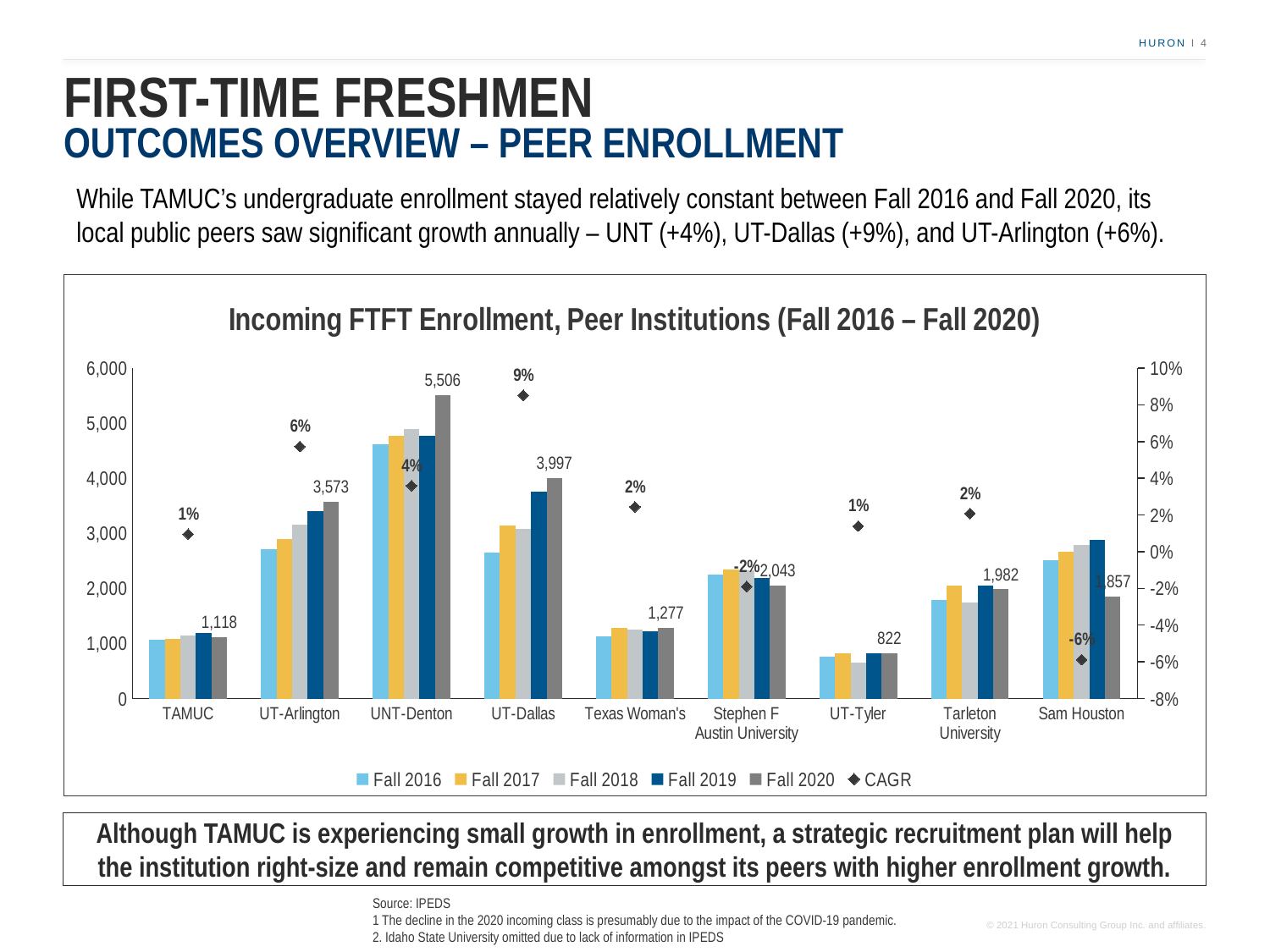
Which institution has the lowest Fall 2020 enrollment? UT-Tyler What is the Fall 2020 incoming FTFT enrollment for TAMUC? 1,118 What CAGR is shown for Sam Houston? -6% How many institutions are shown on the x axis? 9 Is the Fall 2016 enrollment for TAMUC greater or less than 2,000? less What is the Fall 2020 incoming FTFT enrollment for UNT-Denton? 5,506 How many series does the legend list? 6 Which has the larger Fall 2020 enrollment, Tarleton University or Sam Houston? Tarleton University Which institution has the highest Fall 2020 enrollment? UNT-Denton Which institution has the highest CAGR? UT-Dallas What CAGR is shown for UT-Dallas? 9% What is the difference between the Fall 2020 enrollment of UNT-Denton and UT-Dallas? 1,509